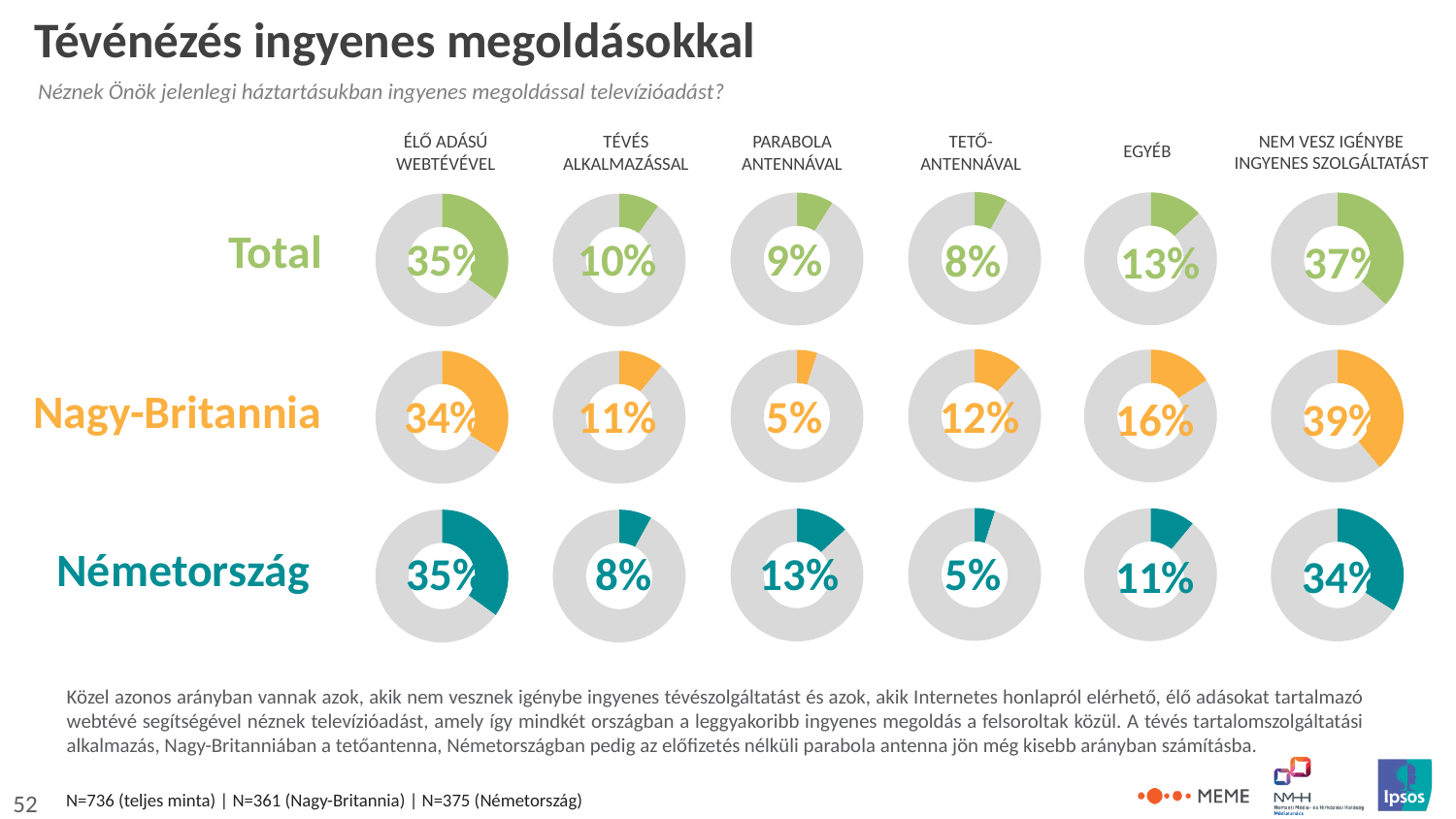
Which is larger: the Parabola antennával percentage for Nagy-Britannia or for Németország? Németország In the Total row, what percentage is shown for Élő adású webtévével? 35% What colour are the donut chart segments in the Nagy-Britannia row? Orange In the Németország row, which category has the lowest percentage? Tető-antennával What type of chart is used to display the percentages on this slide? Donut (pie) chart In the Németország row, what percentage is shown for Nem vesz igénybe ingyenes szolgáltatást? 34% What is the difference between the Total percentages for Nem vesz igénybe ingyenes szolgáltatást and Élő adású webtévével? 2 percentage points How many donut charts are shown in the Total row? 6 In the Nagy-Britannia row, what percentage is shown for Parabola antennával? 5% In the Total row, which category has the highest percentage? Nem vesz igénybe ingyenes szolgáltatást In the Nagy-Britannia row, what percentage is shown for Egyéb? 16% What is the difference between the Nagy-Britannia and Németország percentages for Tető-antennával? 7 percentage points